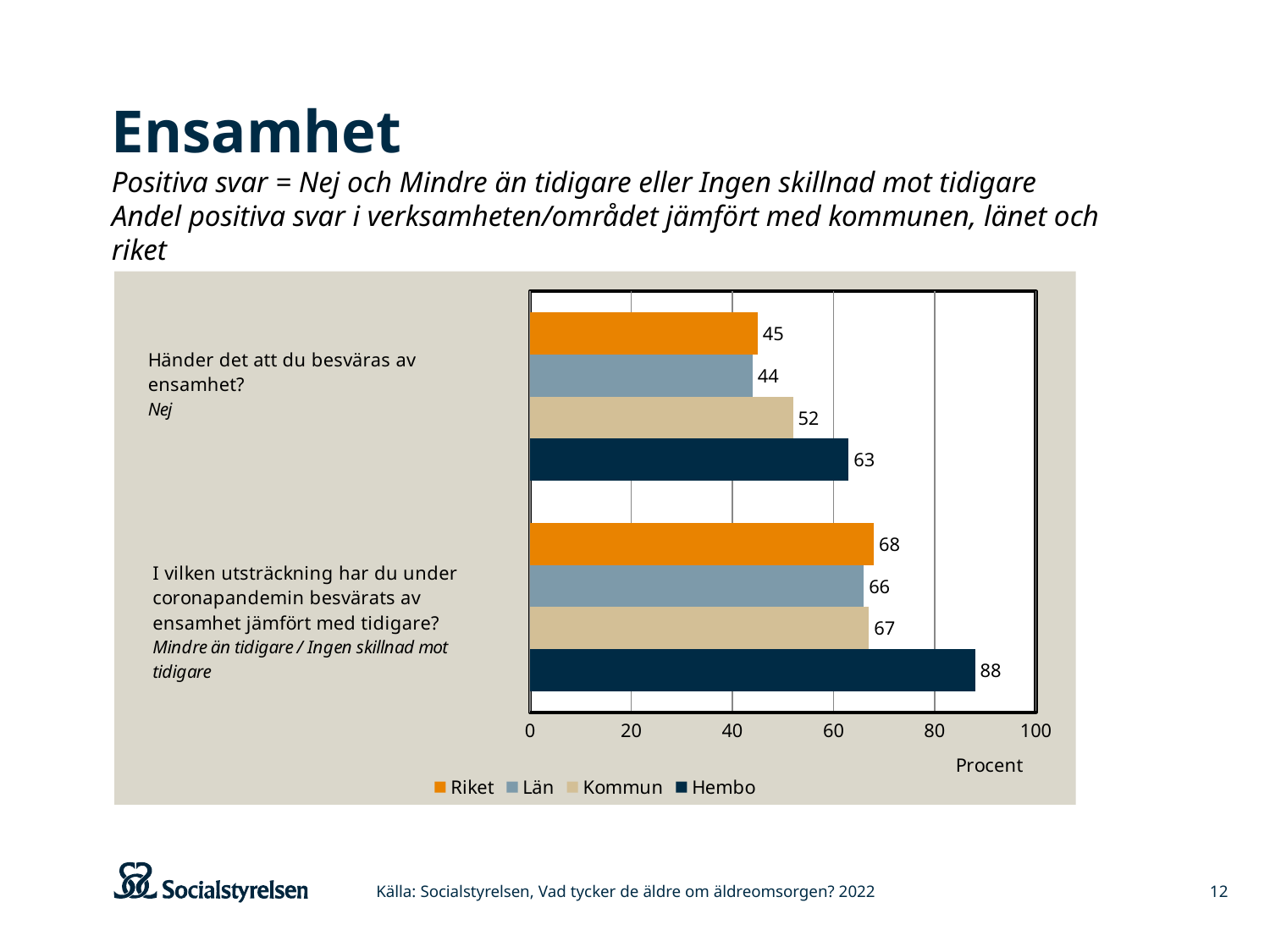
What is the difference between the Hembo and Kommun values for the question 'Händer det att du besväras av ensamhet?' 11 Is the value for Hembo for the question 'I vilken utsträckning har du under coronapandemin besvärats av ensamhet jämfört med tidigare?' greater or less than 80? greater What is the value for Kommun for the question 'Händer det att du besväras av ensamhet?' 52 How many series does the legend list? 4 Which series has the highest value for the question 'I vilken utsträckning har du under coronapandemin besvärats av ensamhet jämfört med tidigare?' Hembo What is the value for Riket for the question 'I vilken utsträckning har du under coronapandemin besvärats av ensamhet jämfört med tidigare?' 68 Which series has the lowest value for the question 'Händer det att du besväras av ensamhet?' Län What is the label on the horizontal axis of the chart? Procent What kind of chart is shown on the slide? Bar chart What is the difference between the Hembo and Riket values for the question 'I vilken utsträckning har du under coronapandemin besvärats av ensamhet jämfört med tidigare?' 20 What is the value for Hembo for the question 'Händer det att du besväras av ensamhet?' 63 Which is larger for the question 'Händer det att du besväras av ensamhet?': the value for Kommun or the value for Riket? Kommun